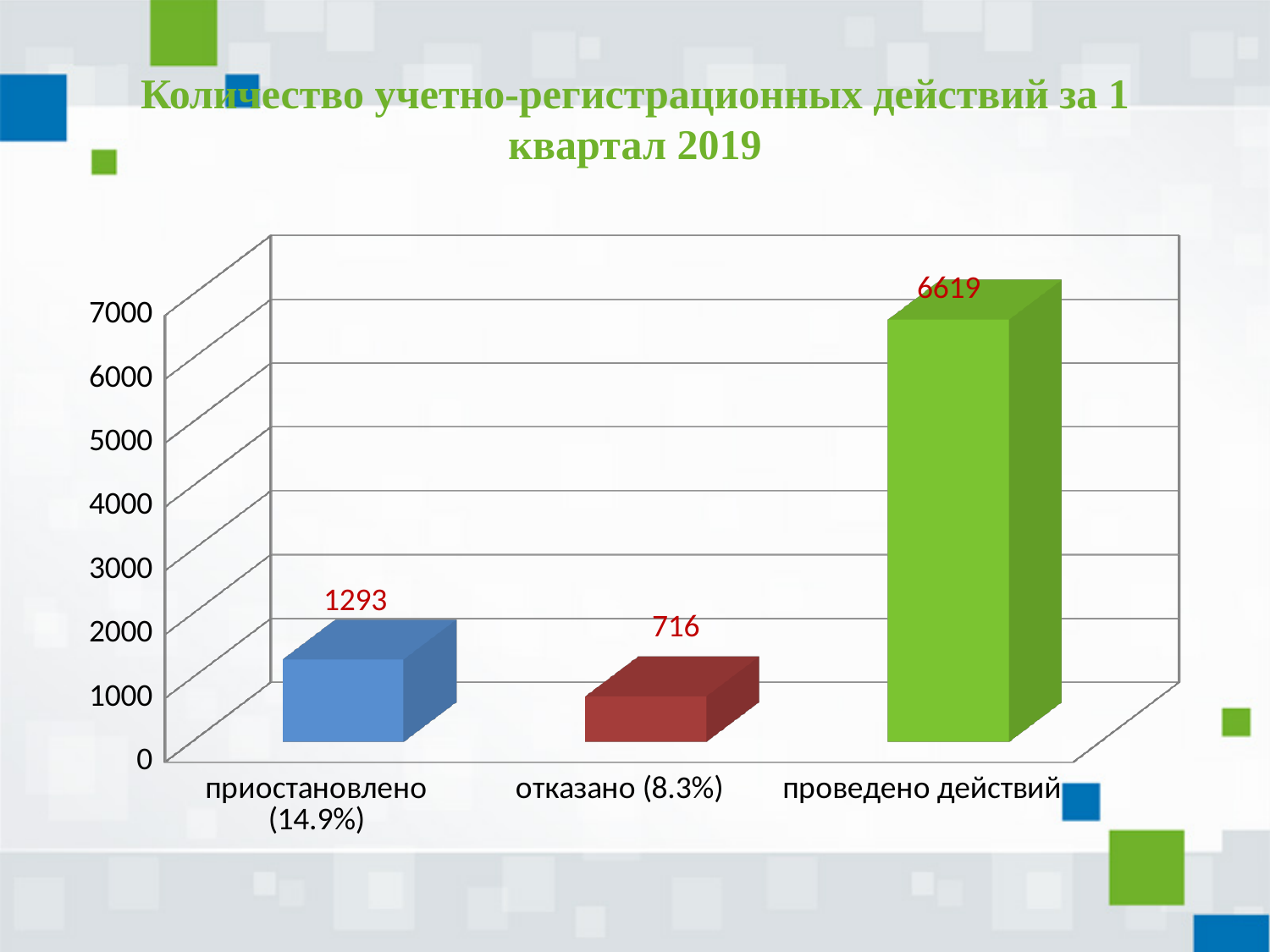
What kind of chart is shown on the slide? bar chart Which category has the highest value? проведено действий Which is larger: the value for "приостановлено (14.9%)" or the value for "отказано (8.3%)"? приостановлено (14.9%) What is the difference between the values for "приостановлено (14.9%)" and "отказано (8.3%)"? 577 Which category has the lowest value? отказано (8.3%) What is the value for "приостановлено (14.9%)"? 1293 What is the value for "отказано (8.3%)"? 716 What is the value for "проведено действий"? 6619 How many categories are shown on the chart? 3 Is the value for "проведено действий" greater or less than 6000? greater What is the difference between the values for "проведено действий" and "приостановлено (14.9%)"? 5326 What is the title of the chart? Количество учетно-регистрационных действий за 1 квартал 2019